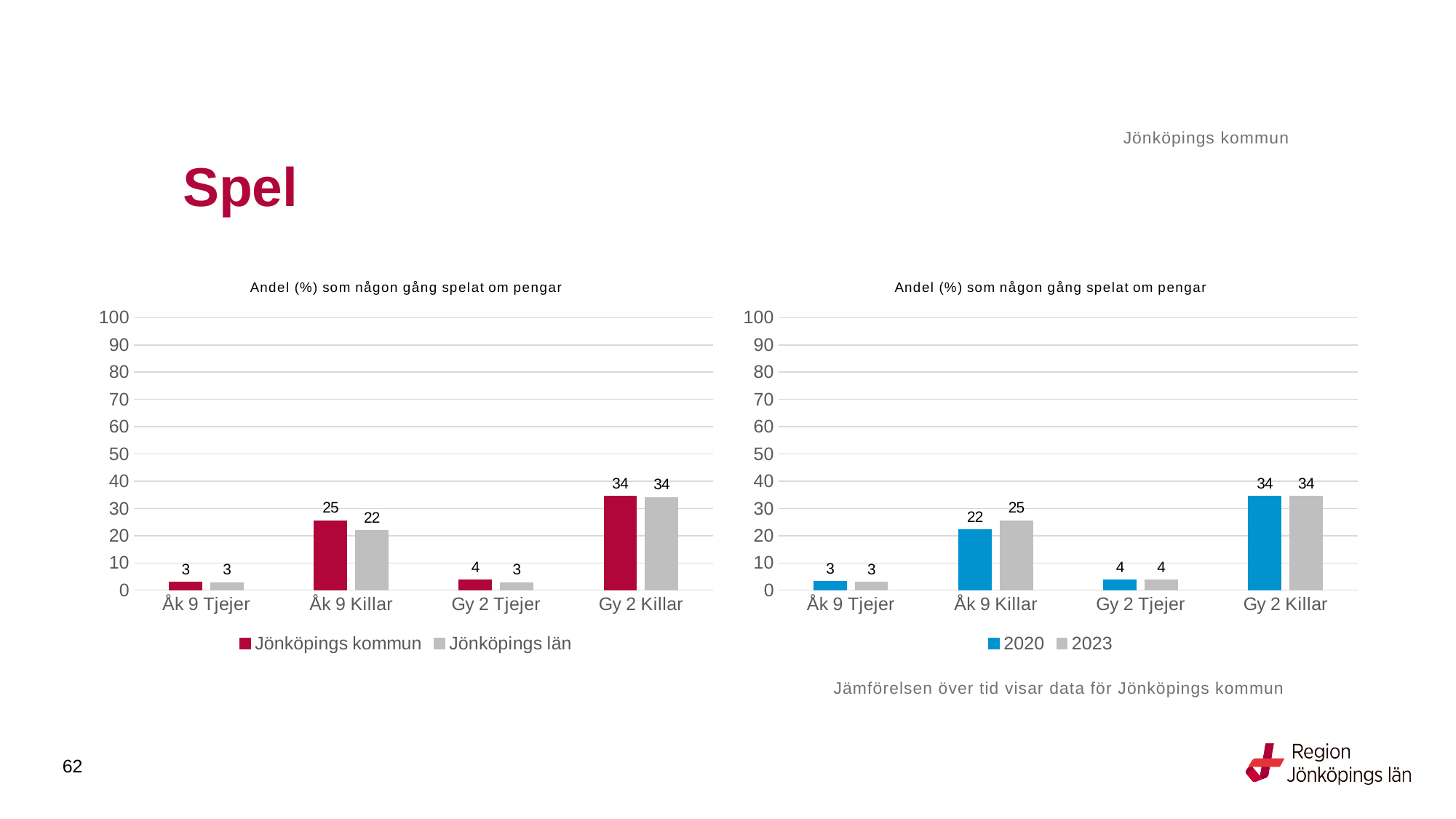
How many categories are shown on the x axis of the right chart? 4 In the right chart, what is the 2020 value for Åk 9 Killar? 22 How many series does the legend of the left chart list? 2 In the right chart, which category has the lowest value for 2023? Åk 9 Tjejer In the left chart, what is the value for Jönköpings län for Gy 2 Tjejer? 3 In the left chart, which is larger for Gy 2 Tjejer: Jönköpings kommun or Jönköpings län? Jönköpings kommun In the left chart, which category has the highest value for Jönköpings kommun? Gy 2 Killar In the left chart, what is the difference between Jönköpings kommun and Jönköpings län for Åk 9 Killar? 3 In the right chart, what is the 2023 value for Gy 2 Tjejer? 4 In the left chart, what is the value for Jönköpings kommun for Åk 9 Killar? 25 In the right chart, what is the difference between the 2023 and 2020 values for Åk 9 Killar? 3 What type of chart is the right chart? Bar chart